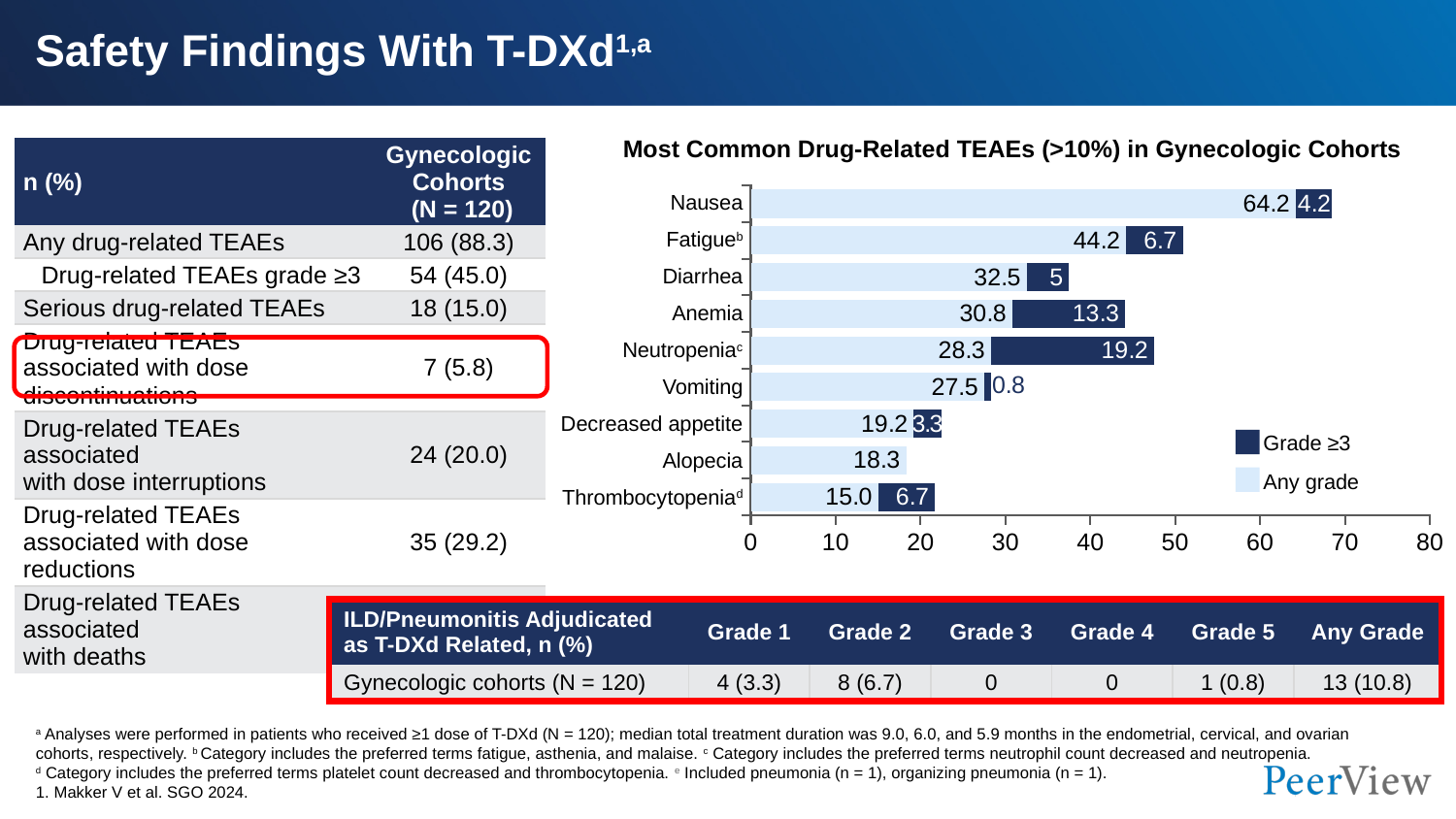
Which has a larger Grade ≥3 value in the chart, Anemia or Diarrhea? Anemia How many series does the chart legend list? 2 What is the title of the chart on the slide? Most Common Drug-Related TEAEs (>10%) in Gynecologic Cohorts What type of chart is shown on the slide? Bar chart What is the Any grade value for Nausea in the chart? 64.2 How many adverse event categories are plotted in the chart? 9 Which category has the highest Grade ≥3 value in the chart? Neutropenia What is the Grade ≥3 value for Neutropenia in the chart? 19.2 What is the difference between the Any grade values for Nausea and Fatigue in the chart? 20.0 What is the Any grade value for Thrombocytopenia in the chart? 15.0 Which category has the highest Any grade value in the chart? Nausea Which category has the lowest Any grade value in the chart? Thrombocytopenia